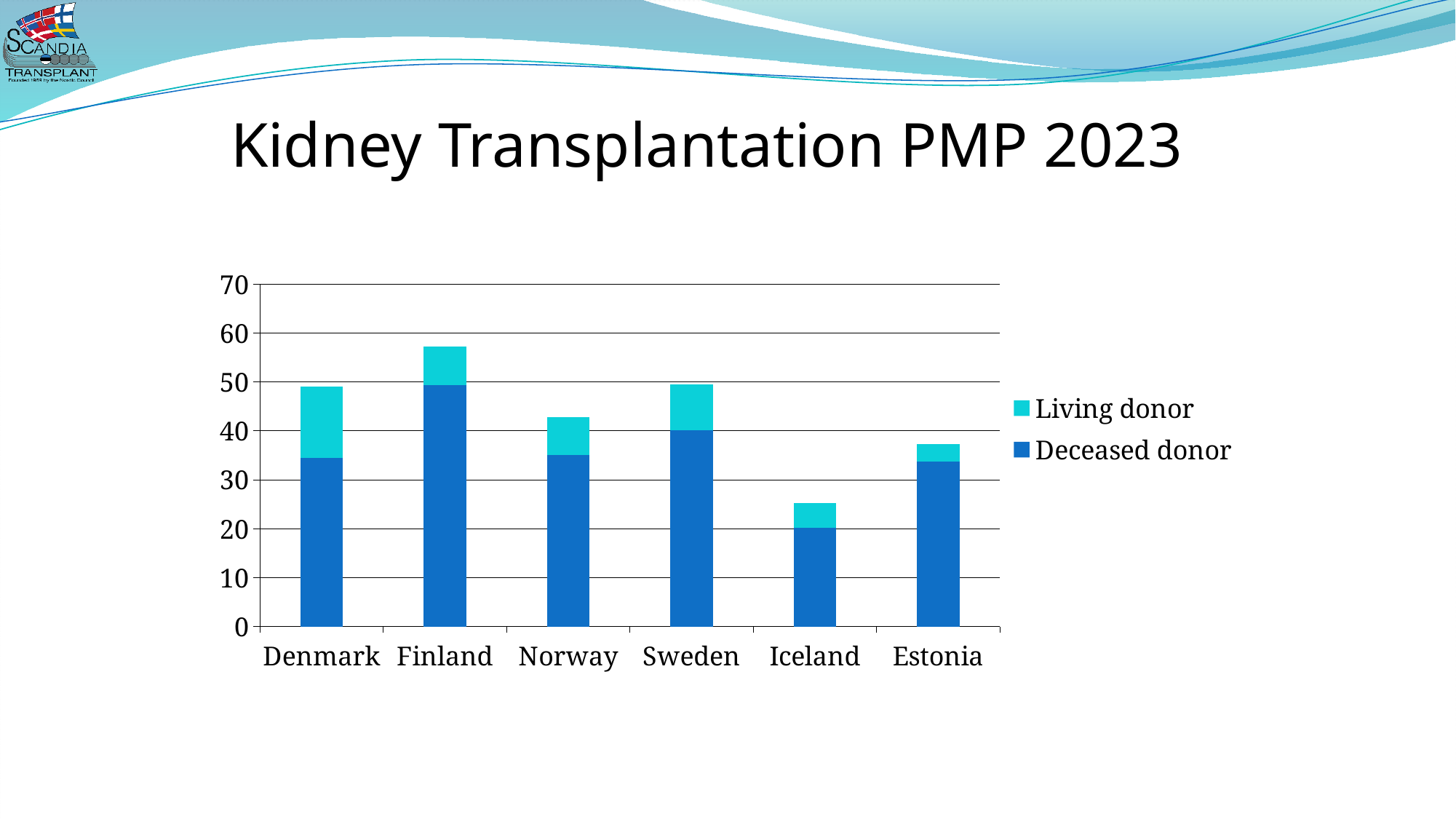
Which country has the largest Deceased donor value? Finland Is the total bar for Finland greater or less than 50? greater Is the total bar for Iceland greater or less than 30? less How many countries are shown on the x axis of the chart? 6 Which country has the lowest total kidney transplantation PMP? Iceland Is the Deceased donor value for Denmark greater or less than 40? less What kind of chart is shown on the slide? Stacked bar chart How many series does the legend list? 2 Which is larger, the total bar for Finland or the total bar for Norway? Finland Which country has the highest total kidney transplantation PMP? Finland What is the title of the chart on the slide? Kidney Transplantation PMP 2023 Which country has the largest Living donor segment? Denmark